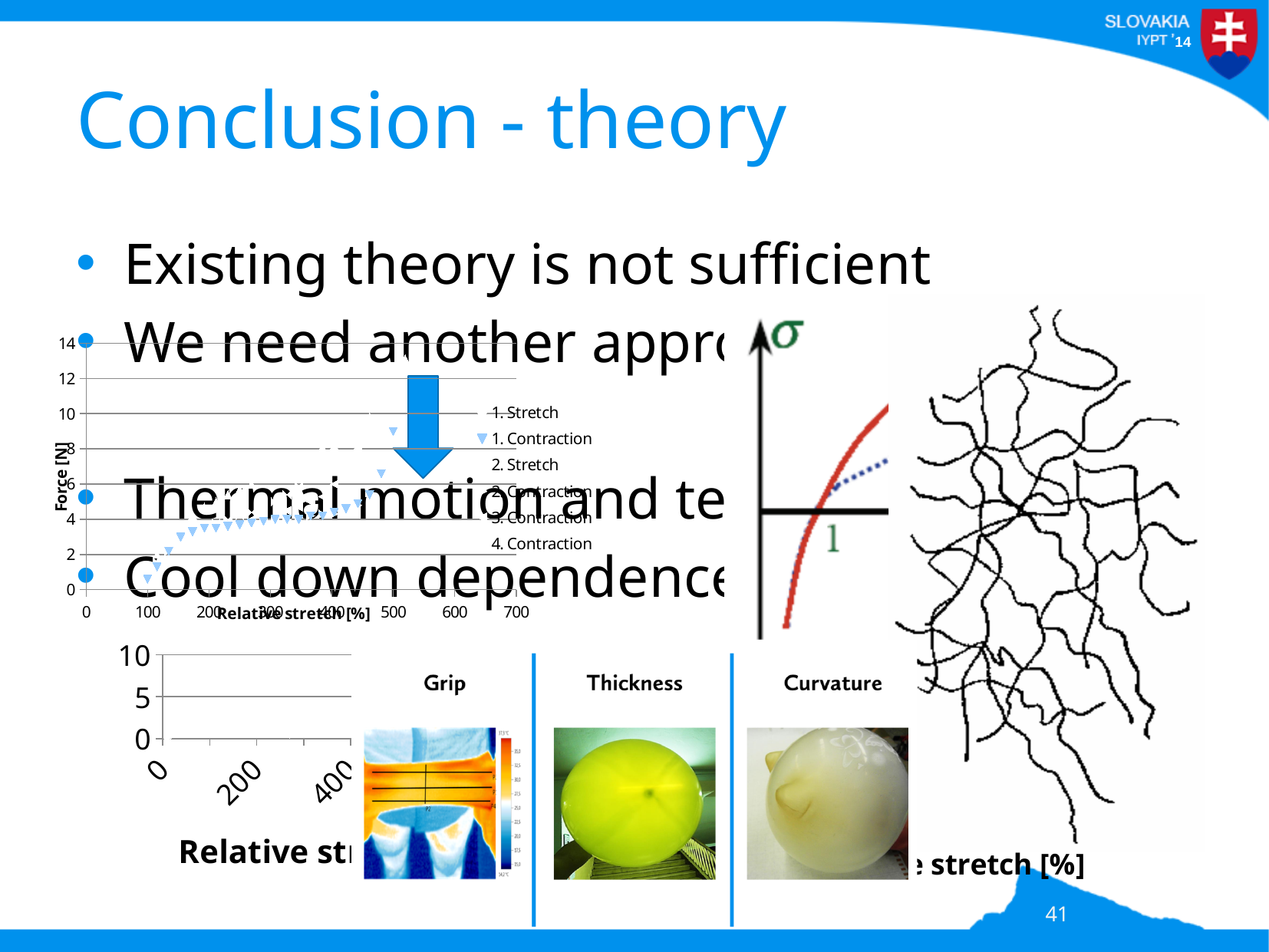
On the Force [N] chart, what is the label of the vertical axis? Force [N] On the Force [N] chart, is the force at a relative stretch of 100% greater or less than 6? less On the Force [N] chart, do the plotted force values rise or fall as relative stretch increases? rise On the Force [N] chart, what is the label of the horizontal axis? Relative stretch [%] On the Force [N] chart, is the force at a relative stretch of 500% greater or less than 6? greater What kind of chart is the Force [N] versus Relative stretch [%] chart on the left of the slide? scatter chart How many series does the legend of the Force [N] chart list? 6 On the small chart at the bottom left of the slide, what is the highest tick value shown on the vertical axis? 10 On the Force [N] chart, what is the highest tick value shown on the horizontal axis? 700 On the Force [N] chart, what is the highest tick value shown on the vertical axis? 14